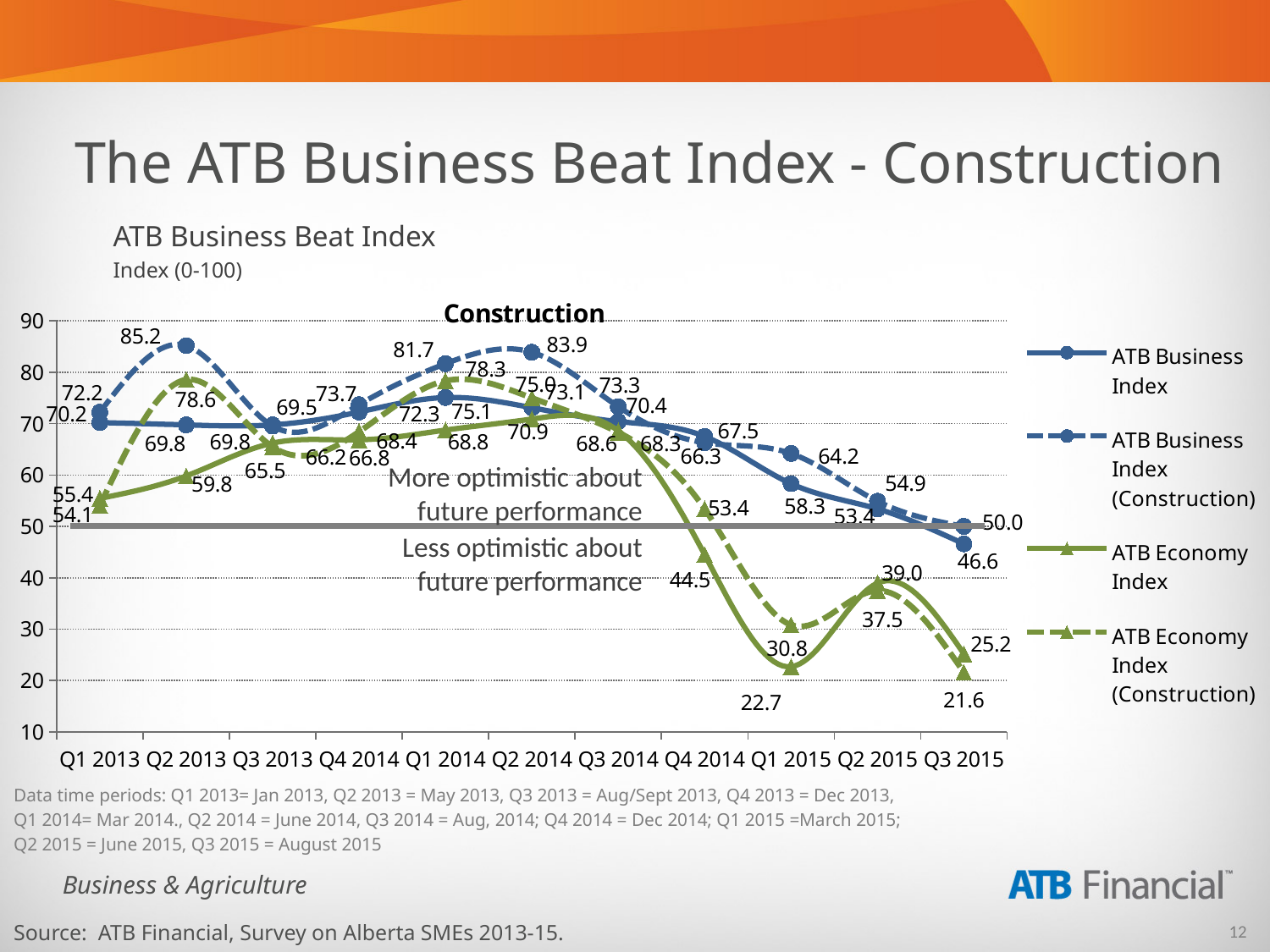
What is the value of the ATB Economy Index (Construction) in Q1 2015? 30.8 How many quarters are shown along the x axis? 11 What type of chart is shown on the slide? Line chart How many series does the legend list? 4 In which quarter does the ATB Business Index (Construction) reach its highest value? Q2 2013 Is the value of the ATB Economy Index (Construction) in Q3 2015 greater or less than 30? less What is the value of the ATB Economy Index in Q3 2015? 25.2 What is the value of the ATB Business Index (Construction) in Q3 2015? 50.0 What is the difference between the ATB Business Index (Construction) and the ATB Business Index in Q3 2015? 3.4 In Q1 2015, which is larger: the ATB Business Index (Construction) or the ATB Economy Index (Construction)? ATB Business Index (Construction) Does the ATB Economy Index (Construction) rise or fall from Q2 2014 to Q1 2015? fall What is the value of the ATB Business Index (Construction) in Q2 2013? 85.2